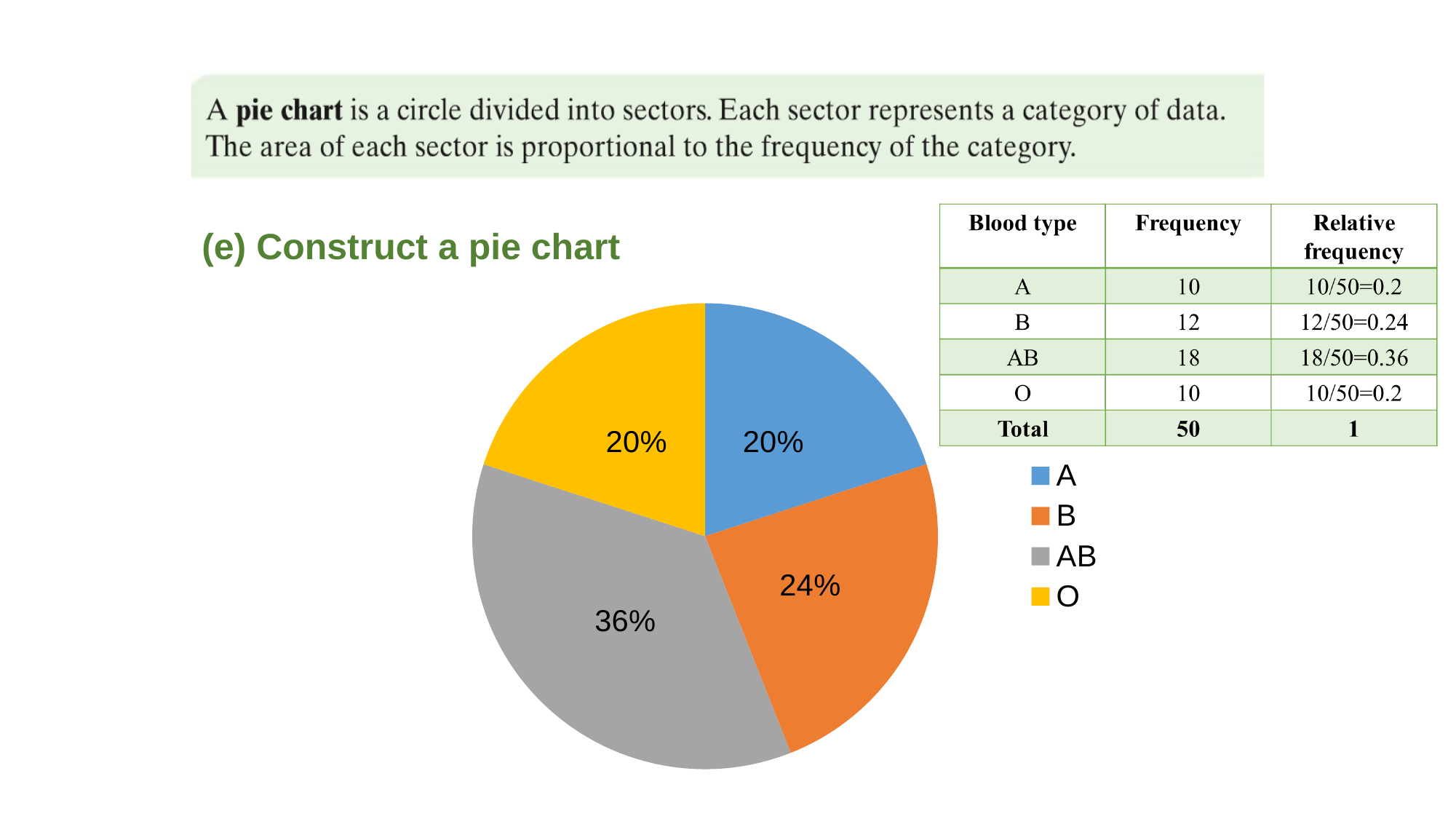
How many entries does the legend of the pie chart list? 4 What percentage of the pie chart does blood type AB represent? 36% What percentage of the pie chart does blood type B represent? 24% What type of chart is shown on the slide? pie chart What colour is the slice for blood type O in the pie chart? yellow How many slices does the pie chart have? 4 Which blood type has the largest slice in the pie chart? AB Which slice is larger in the pie chart, B or A? B What percentage of the pie chart does blood type O represent? 20% What colour is the slice for blood type AB in the pie chart? grey What is the difference in percentage points between the AB slice and the B slice? 12 What percentage of the pie chart does blood type A represent? 20%